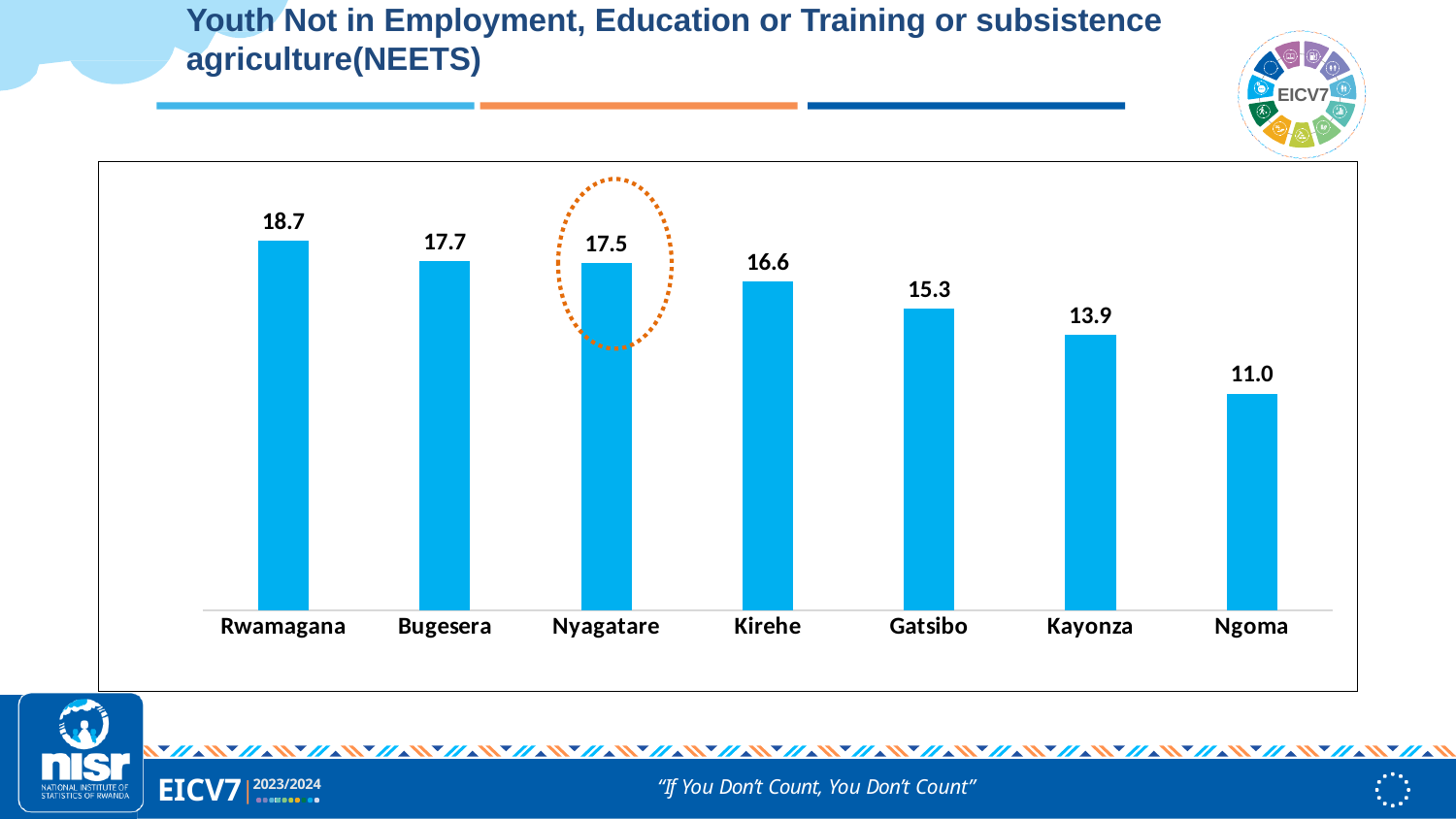
Do the values rise or fall from left to right across the districts? Fall How many districts are shown on the chart? 7 Which is larger, the value for Bugesera or the value for Kirehe? Bugesera Which district's bar is highlighted with a dotted orange circle? Nyagatare What is the value for Rwamagana? 18.7 What is the difference between the values for Rwamagana and Ngoma? 7.7 What is the value for Kayonza? 13.9 Which district has the highest value? Rwamagana Which district has the lowest value? Ngoma What is the difference between the values for Kirehe and Gatsibo? 1.3 What is the value for Nyagatare? 17.5 What kind of chart is shown on the slide? Bar chart